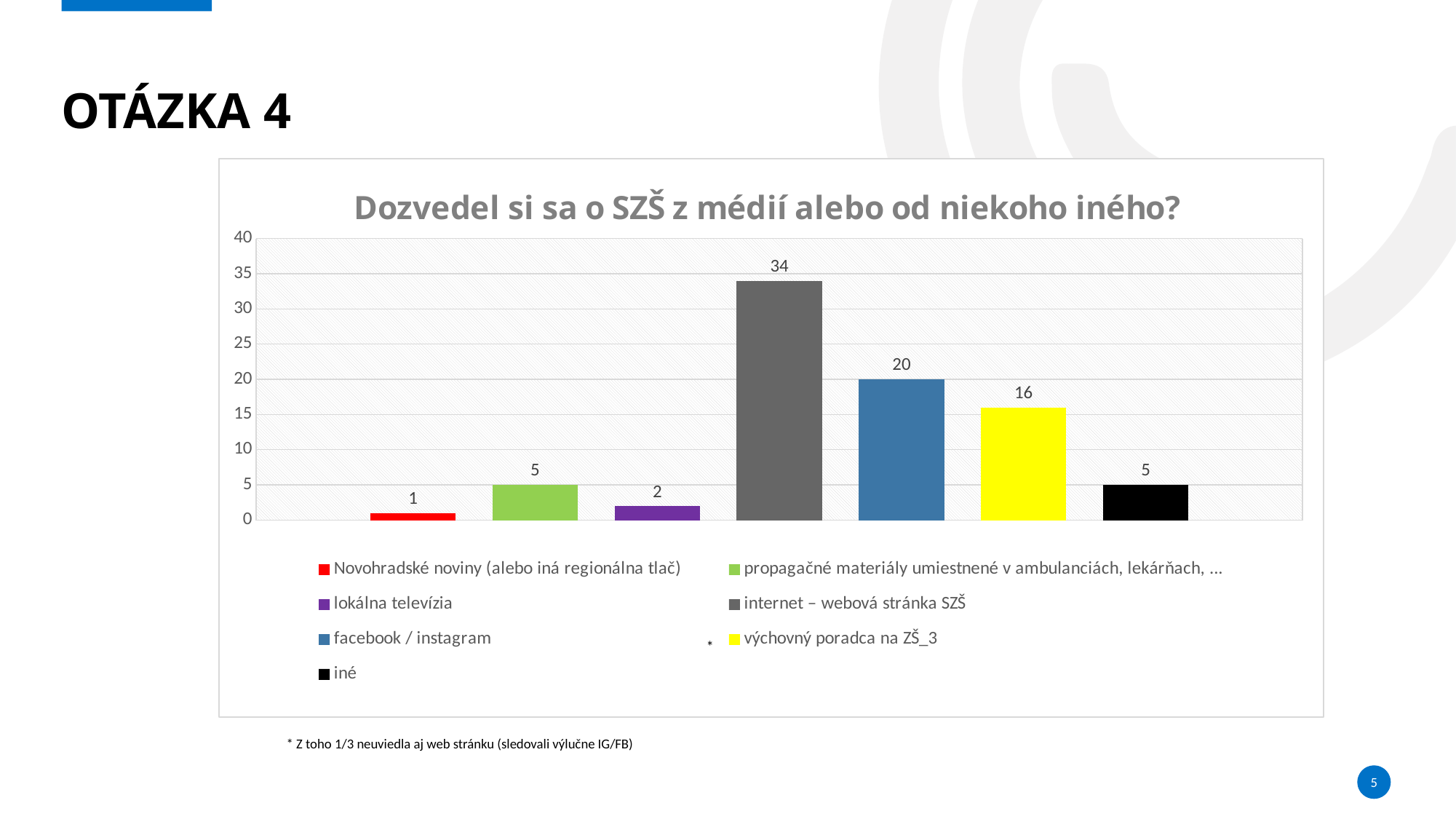
What is the value for "internet – webová stránka SZŠ"? 34 How many series does the legend list? 7 What is the value for "lokálna televízia"? 2 What kind of chart is shown on the slide? bar chart What is the title of the chart? Dozvedel si sa o SZŠ z médií alebo od niekoho iného? What is the value for "výchovný poradca na ZŠ_3"? 16 Which is larger, the value for "facebook / instagram" or the value for "výchovný poradca na ZŠ_3"? facebook / instagram Which category has the lowest value? Novohradské noviny (alebo iná regionálna tlač) What is the value for "facebook / instagram"? 20 Which category has the highest value? internet – webová stránka SZŠ Is the value for "internet – webová stránka SZŠ" greater or less than 30? greater What is the difference between the values for "internet – webová stránka SZŠ" and "facebook / instagram"? 14